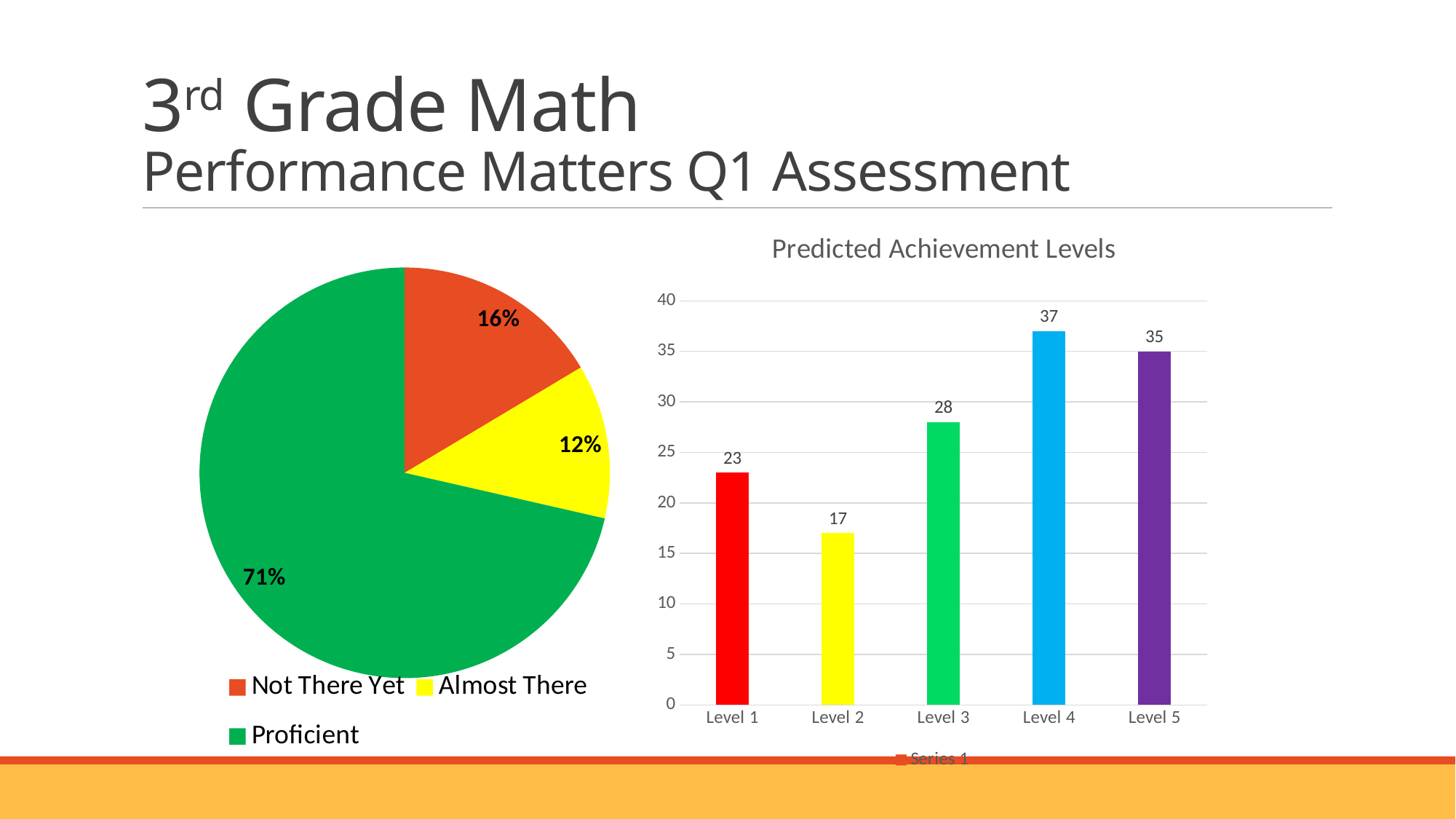
In the Predicted Achievement Levels chart, what is the value for Level 3? 28 In the Predicted Achievement Levels chart, which level has the highest value? Level 4 In the Predicted Achievement Levels chart, what is the difference between the values for Level 4 and Level 1? 14 In the Predicted Achievement Levels chart, which level has the lowest value? Level 2 In the pie chart on the left, how many categories does the legend list? 3 In the pie chart on the left, what share is labelled for Not There Yet? 16% In the pie chart on the left, what share is labelled for Proficient? 71% In the Predicted Achievement Levels chart, how many levels are shown on the x axis? 5 In the Predicted Achievement Levels chart, which is larger, the value for Level 1 or the value for Level 3? Level 3 What kind of chart is the Predicted Achievement Levels chart? Bar chart In the pie chart on the left, which category has the smallest slice? Almost There In the Predicted Achievement Levels chart, what is the value for Level 2? 17